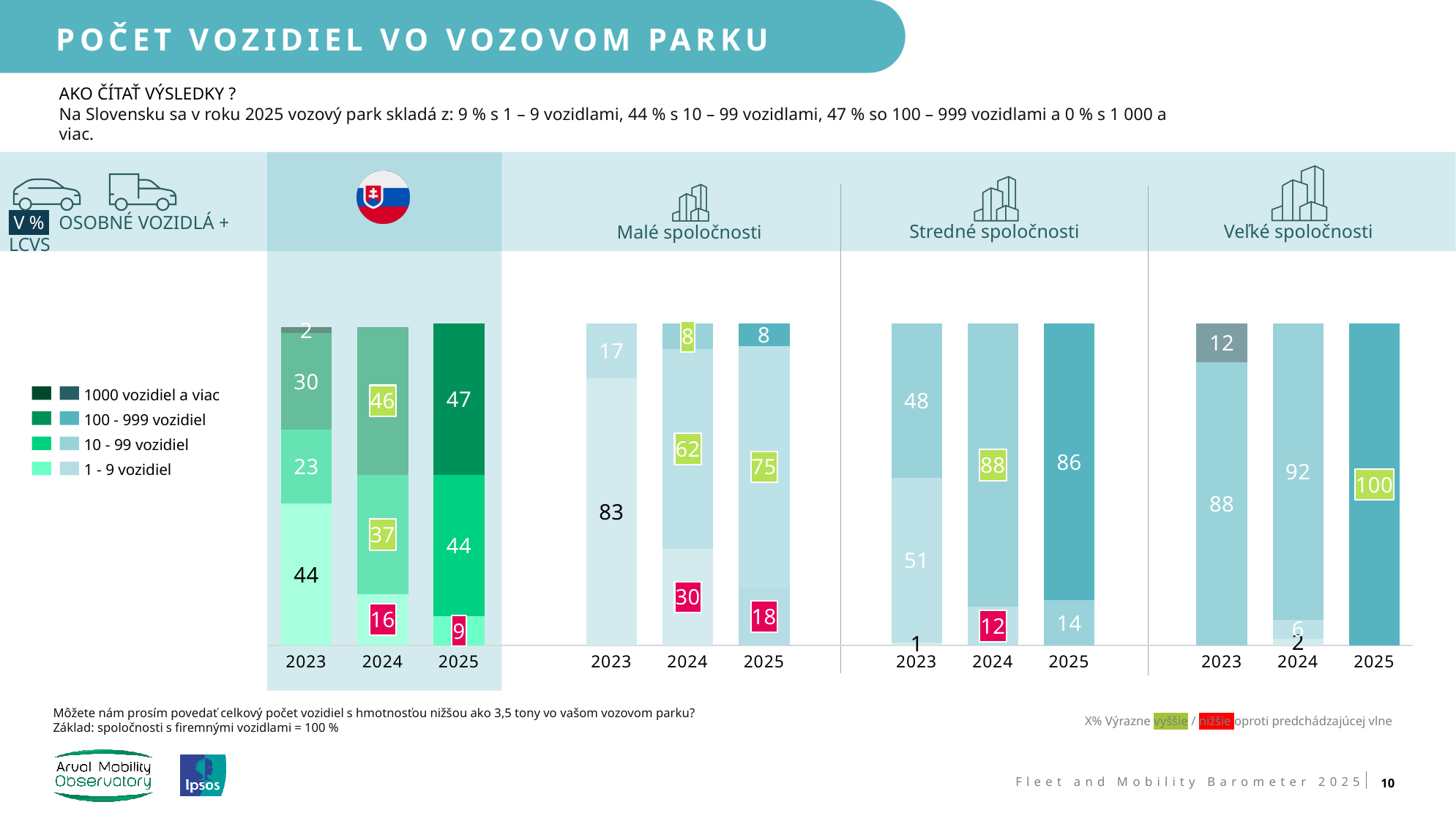
What kind of chart is used on this slide? Stacked bar chart In the Slovakia (overall) chart, does the 1 - 9 vozidiel value rise or fall from 2023 to 2025? Fall In the Slovakia (overall) chart, what is the value for the 100 - 999 vozidiel segment in 2025? 47 In the Malé spoločnosti chart, what is the value for the 1 - 9 vozidiel segment in 2023? 83 In the Slovakia (overall) chart, which year has the highest value for the 1 - 9 vozidiel segment? 2023 In the Slovakia (overall) chart, what is the difference between the 100 - 999 vozidiel values for 2025 and 2023? 17 In the Stredné spoločnosti chart, is the 10 - 99 vozidiel value larger in 2024 or in 2025? 2025 In the Stredné spoločnosti chart, what is the value for the 100 - 999 vozidiel segment in 2025? 86 How many series does the legend list? 4 In the Slovakia (overall) chart, what is the value for the 1 - 9 vozidiel segment in 2023? 44 In the Veľké spoločnosti chart, what is the value for the 100 - 999 vozidiel segment in 2025? 100 In the Malé spoločnosti chart, which year has the lowest value for the 1 - 9 vozidiel segment? 2025